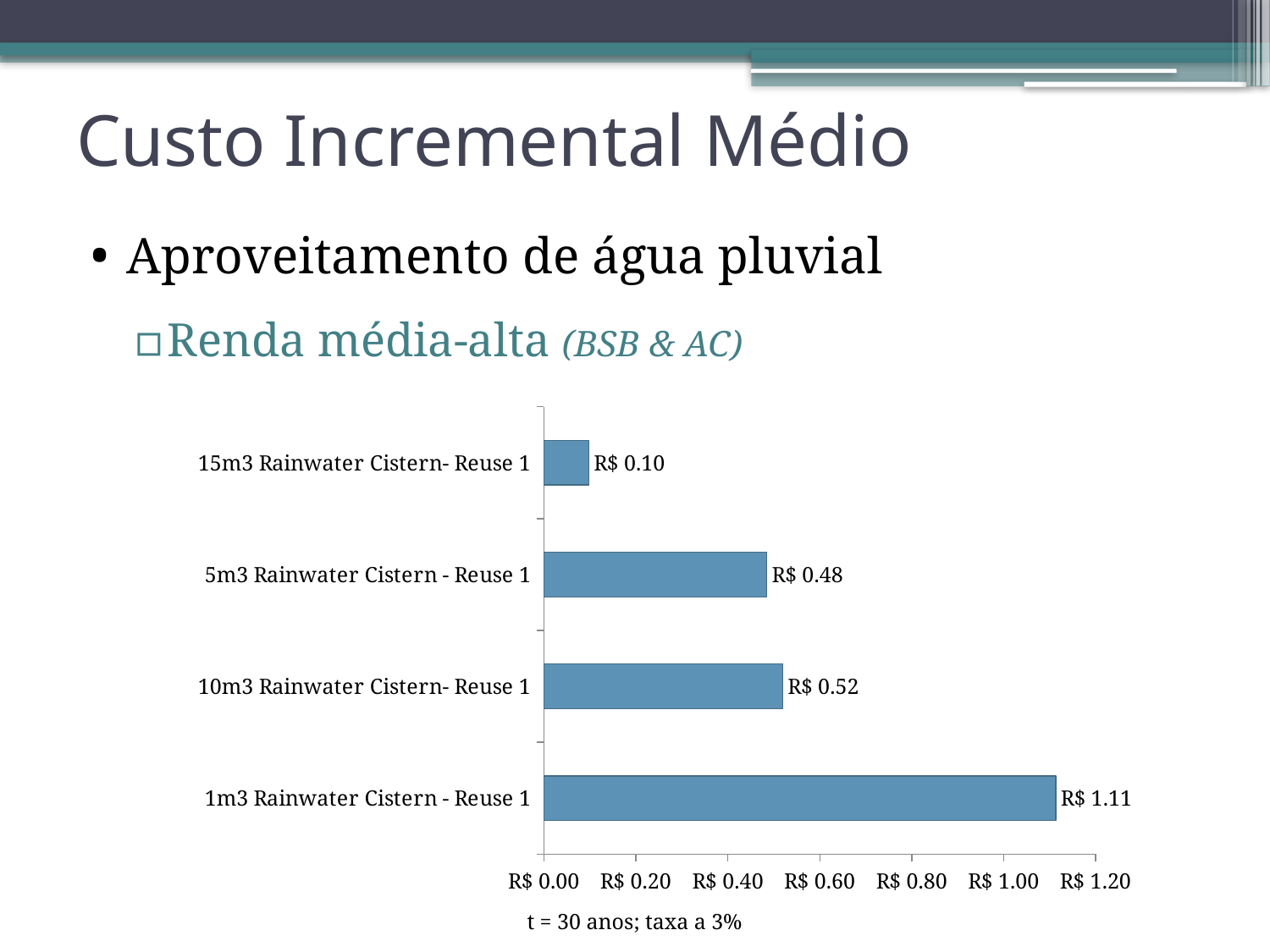
Which category has the lowest value? 15m3 Rainwater Cistern- Reuse 1 What is the value for 1m3 Rainwater Cistern - Reuse 1? R$ 1.11 What is the value for 5m3 Rainwater Cistern - Reuse 1? R$ 0.48 Is the value for 1m3 Rainwater Cistern - Reuse 1 greater or less than R$ 1.00? greater Which is larger, the value for 1m3 Rainwater Cistern - Reuse 1 or the value for 10m3 Rainwater Cistern- Reuse 1? 1m3 Rainwater Cistern - Reuse 1 What is the difference between the values for 10m3 Rainwater Cistern- Reuse 1 and 5m3 Rainwater Cistern - Reuse 1? R$ 0.04 What is the difference between the values for 1m3 Rainwater Cistern - Reuse 1 and 15m3 Rainwater Cistern- Reuse 1? R$ 1.01 What is the value for 10m3 Rainwater Cistern- Reuse 1? R$ 0.52 How many categories are shown in the chart? 4 What is the value for 15m3 Rainwater Cistern- Reuse 1? R$ 0.10 What kind of chart is shown on the slide? bar chart Which category has the highest value? 1m3 Rainwater Cistern - Reuse 1